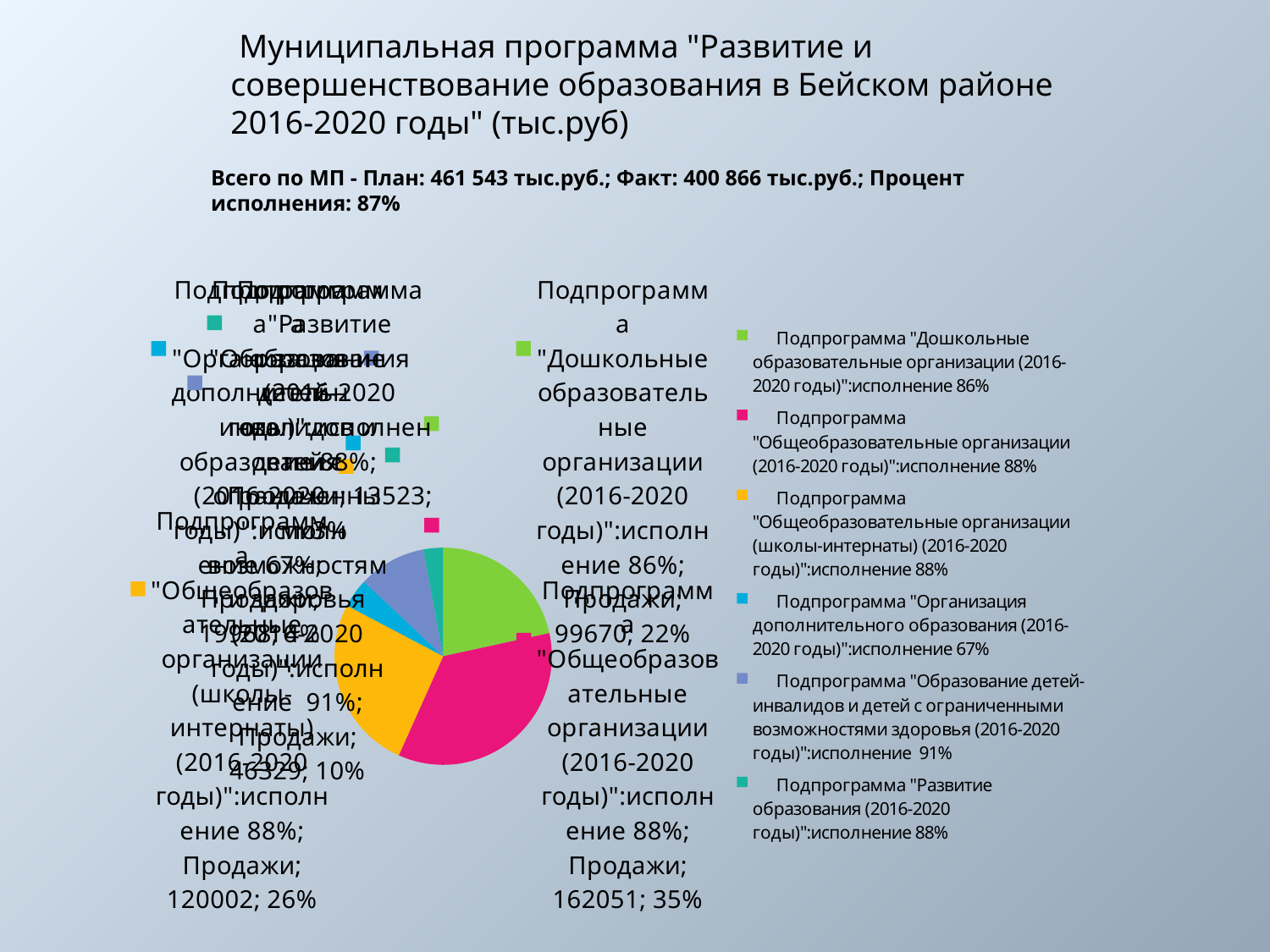
Which slice is larger: Дошкольные образовательные организации or Общеобразовательные организации (школы-интернаты)? Общеобразовательные организации (школы-интернаты) What share of the pie does the slice for Подпрограмма "Общеобразовательные организации (2016-2020 годы)" represent? 35% According to the legend, what execution percentage is given for Подпрограмма "Организация дополнительного образования (2016-2020 годы)"? 67% Which subprogram has the largest slice of the pie chart? Подпрограмма "Общеобразовательные организации (2016-2020 годы)" What value is labelled on the slice for Подпрограмма "Дошкольные образовательные организации (2016-2020 годы)"? 99670 How many entries does the legend of the pie chart list? 6 How many slices does the pie chart have? 6 What value is labelled on the slice for Подпрограмма "Общеобразовательные организации (школы-интернаты) (2016-2020 годы)"? 120002 What kind of chart is shown on the slide? pie chart What share of the pie does the slice for Подпрограмма "Дошкольные образовательные организации (2016-2020 годы)" represent? 22% What is the difference between the values for Общеобразовательные организации (162051) and Общеобразовательные организации (школы-интернаты) (120002)? 42049 What value is labelled on the slice for Подпрограмма "Общеобразовательные организации (2016-2020 годы)"? 162051